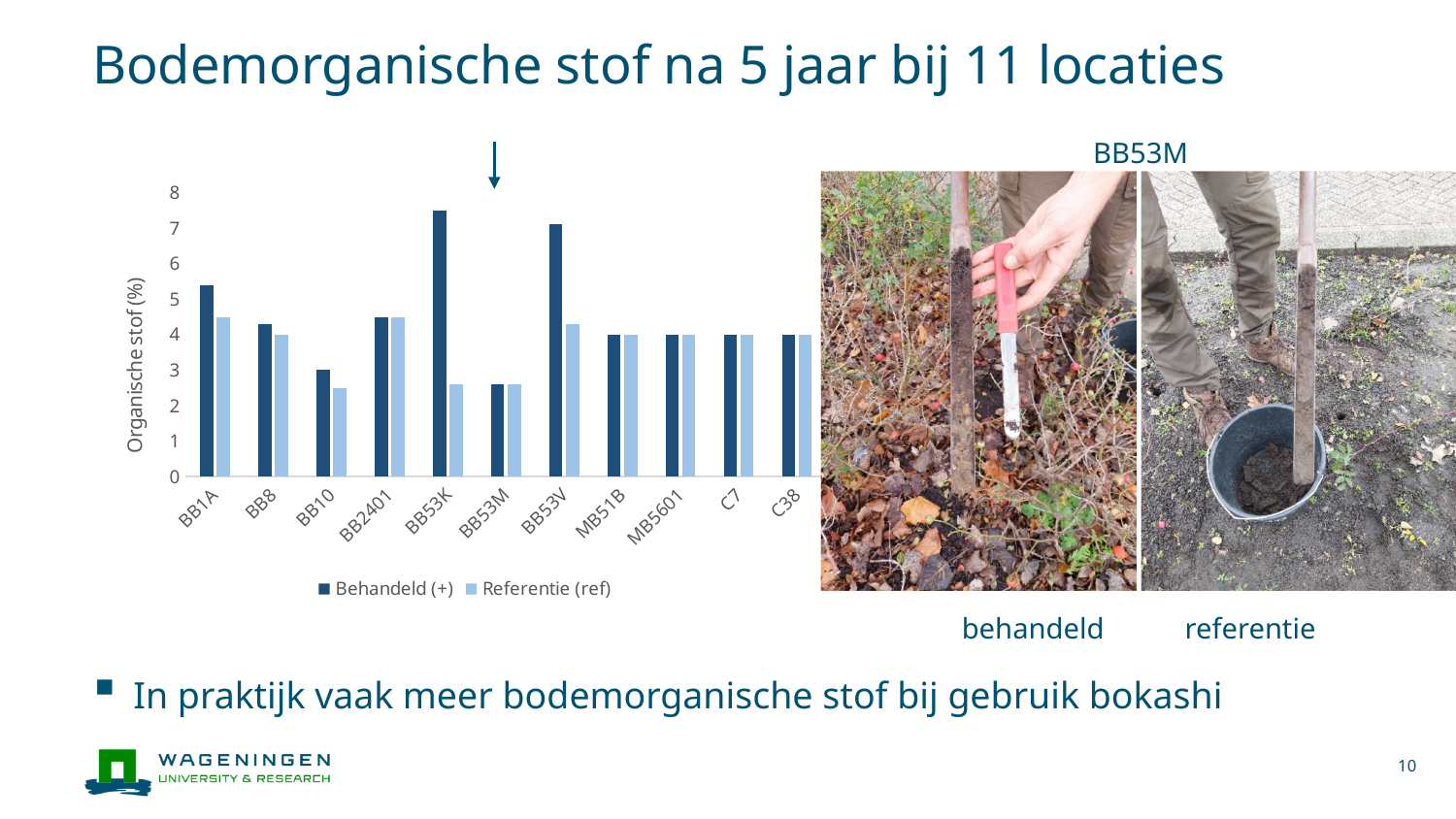
Is the Referentie (ref) value for BB10 greater or less than 3? less How many series does the chart legend list? 2 What kind of chart is shown on the slide? bar chart How many locations (categories) are shown on the x axis of the chart? 11 For BB53V, which is larger: the Behandeld (+) value or the Referentie (ref) value? Behandeld (+) Is the Behandeld (+) value for BB53K greater or less than 7? greater Is the Behandeld (+) value for BB1A greater or less than 5? greater What are the two legend entries of the chart? Behandeld (+) and Referentie (ref) Which location has the highest Behandeld (+) value? BB53K What is the label of the vertical axis of the chart? Organische stof (%)